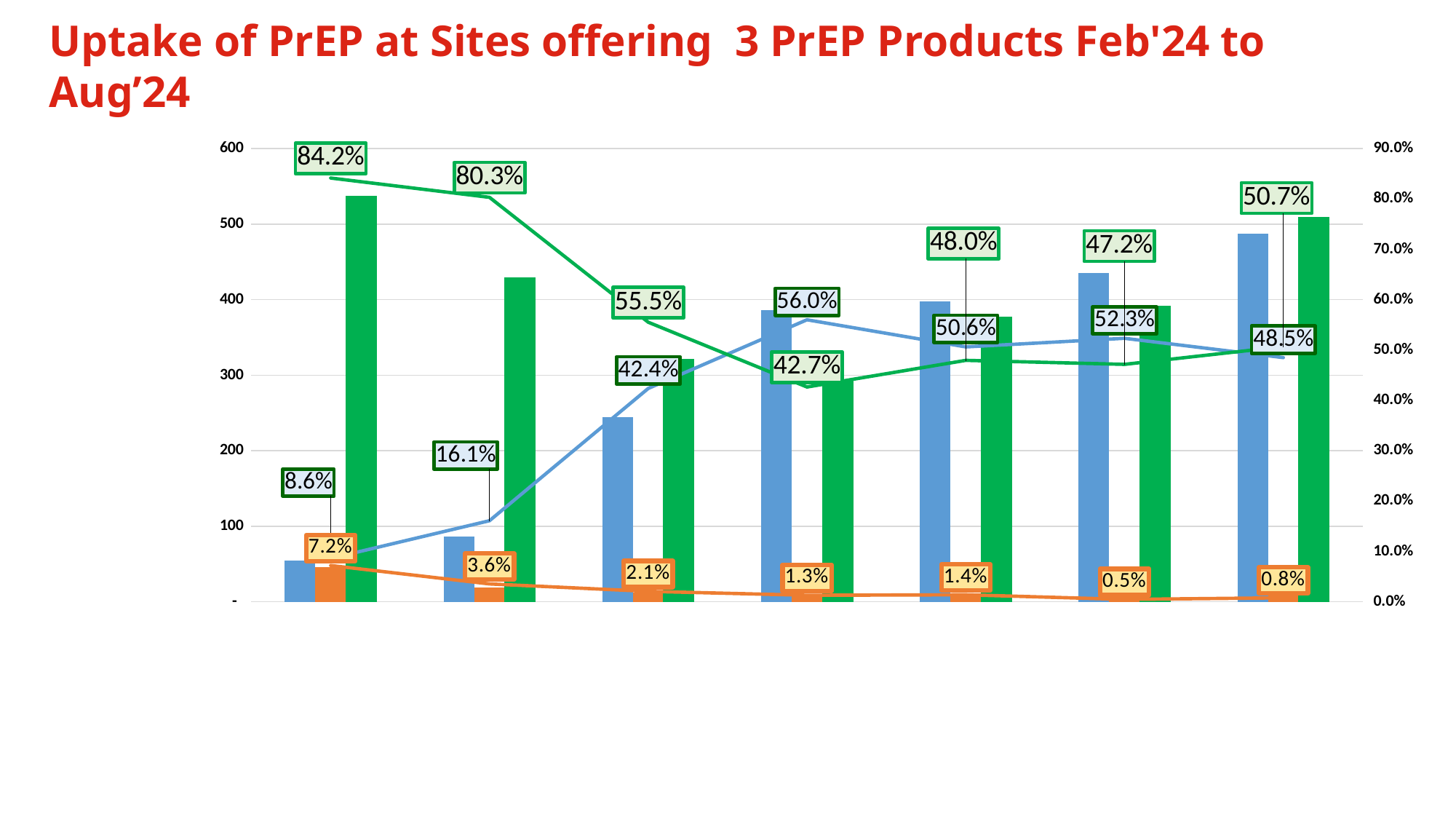
Does the orange line generally rise or fall from left to right? Fall What is the value of the green line's data label at the first (leftmost) group? 84.2% What is the lowest labelled value on the orange line? 0.5% What is the value of the orange line's data label at the last (rightmost) group? 0.8% What is the difference between the green line's labels at the first and second groups (84.2% and 80.3%)? 3.9 percentage points What is the value of the blue line's data label at the fourth group from the left? 56.0% At which group does the green line reach its highest labelled value? The first (leftmost) group, 84.2% At the first group, which is larger: the green line's label or the blue line's label? The green line (84.2%) Is the green bar in the first (leftmost) group greater or less than 500 on the left axis? greater How many groups of bars are plotted along the x axis? 7 What kind of chart is shown on the slide? Combined bar and line chart What is the title of the chart on the slide? Uptake of PrEP at Sites offering 3 PrEP Products Feb'24 to Aug'24